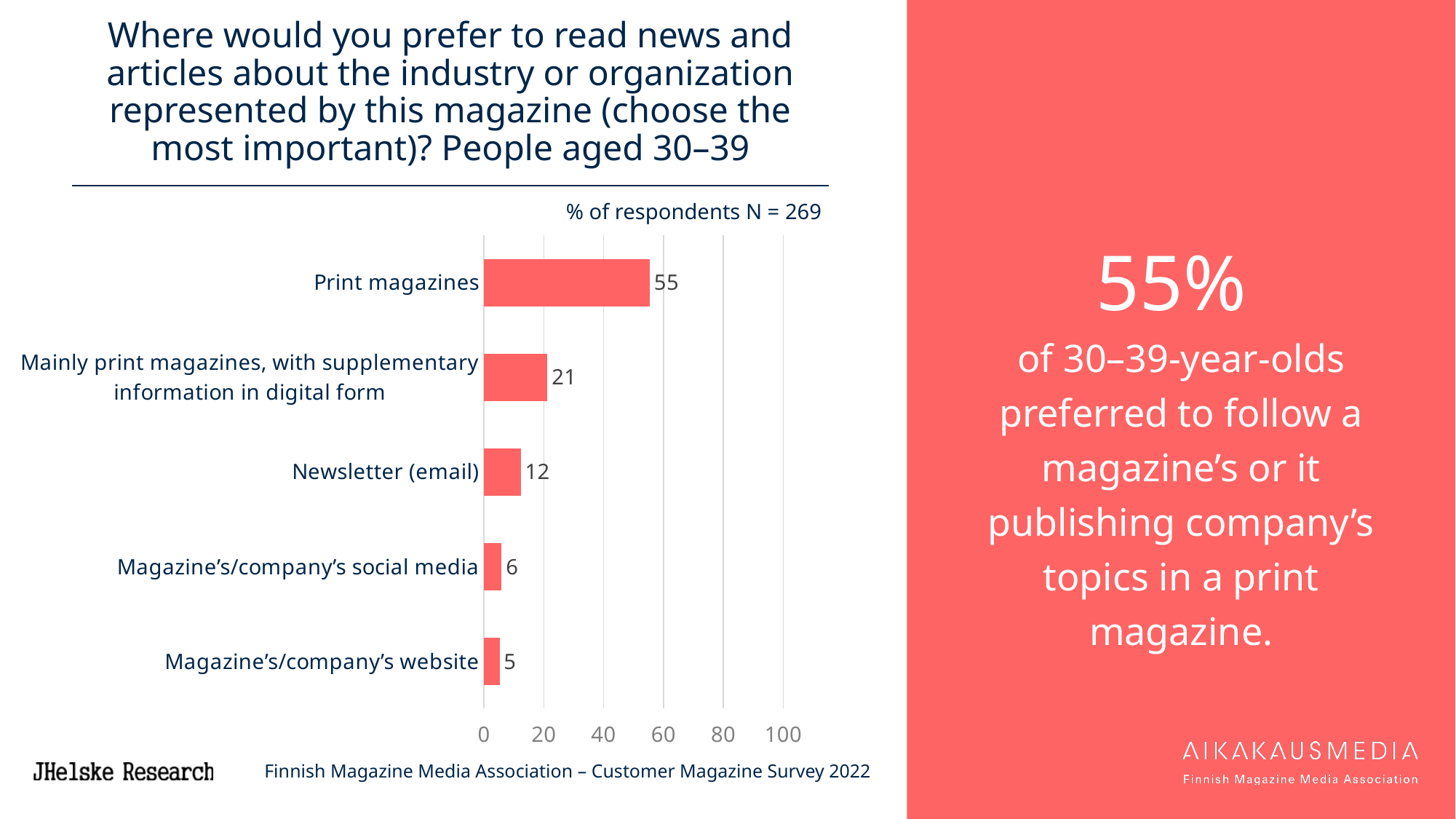
Is the value for Print magazines greater or less than 40? greater What is the value for Newsletter (email)? 12 What percentage of respondents chose Print magazines? 55 Which is larger: Magazine’s/company’s social media or Magazine’s/company’s website? Magazine’s/company’s social media What is the sample size (N) stated above the chart? 269 How many categories are shown in the chart? 5 What kind of chart is shown on the slide? Bar chart What is the difference between the values for Print magazines and Newsletter (email)? 43 What is the value for Mainly print magazines, with supplementary information in digital form? 21 What is the highest value shown on the x axis? 100 Which category has the lowest value? Magazine’s/company’s website Which category has the highest value? Print magazines